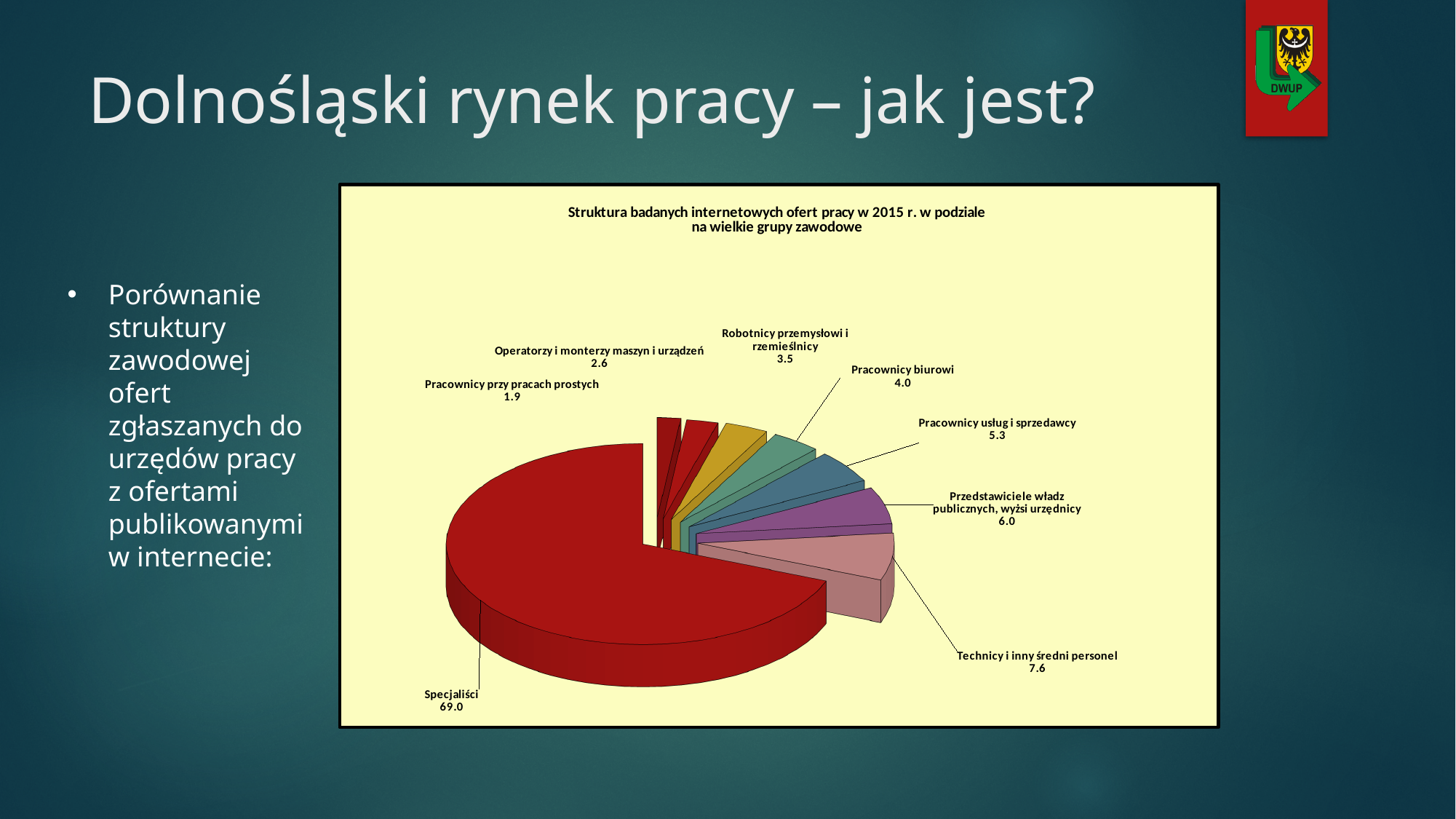
Which category has the largest slice of the pie? Specjaliści What type of chart is shown on the slide? pie chart What is the value for Pracownicy biurowi? 4.0 Which is larger: the value for Robotnicy przemysłowi i rzemieślnicy or the value for Operatorzy i monterzy maszyn i urządzeń? Robotnicy przemysłowi i rzemieślnicy What is the value for Specjaliści? 69.0 What is the difference between the values for Przedstawiciele władz publicznych, wyżsi urzędnicy and Pracownicy usług i sprzedawcy? 0.7 How many categories (slices) does the pie chart have? 8 What is the title of the chart? Struktura badanych internetowych ofert pracy w 2015 r. w podziale na wielkie grupy zawodowe What is the value for Technicy i inny średni personel? 7.6 What is the value for Pracownicy przy pracach prostych? 1.9 Which category has the smallest slice of the pie? Pracownicy przy pracach prostych What is the difference between the values for Specjaliści and Technicy i inny średni personel? 61.4